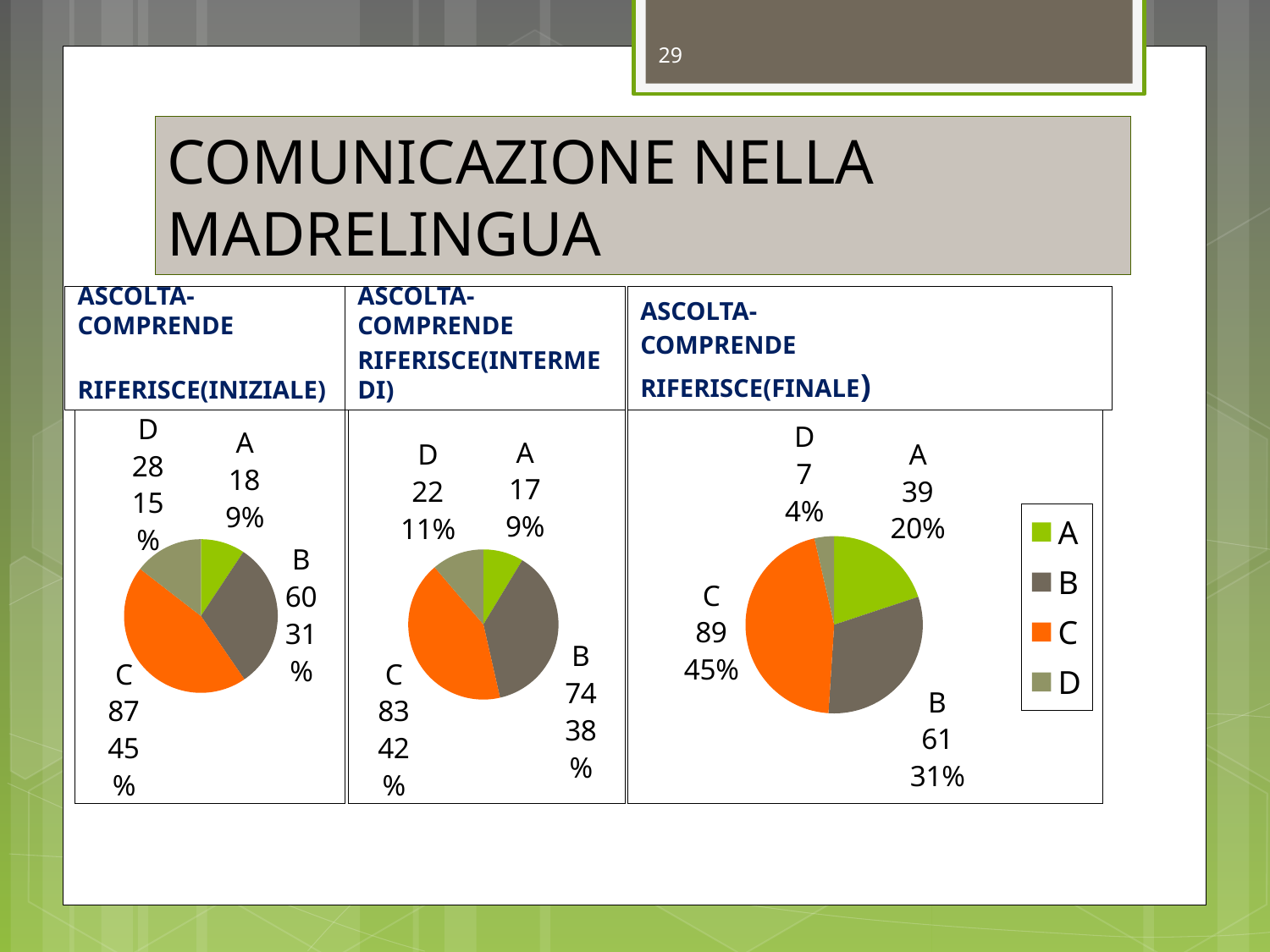
In the ASCOLTA-COMPRENDE RIFERISCE(INIZIALE) chart, what is the value for C? 87 In the ASCOLTA-COMPRENDE RIFERISCE(INIZIALE) chart, what percentage share does B have? 31% In the ASCOLTA-COMPRENDE RIFERISCE(INTERMEDI) chart, which category has the highest value? C What type of chart is used in the ASCOLTA-COMPRENDE RIFERISCE(FINALE) panel? Pie chart In the ASCOLTA-COMPRENDE RIFERISCE(FINALE) chart, what percentage share does D have? 4% How many categories does the legend of the ASCOLTA-COMPRENDE RIFERISCE(FINALE) chart list? 4 In the ASCOLTA-COMPRENDE RIFERISCE(INIZIALE) chart, which category has the lowest value? A In the ASCOLTA-COMPRENDE RIFERISCE(FINALE) chart, what is the value for A? 39 In the ASCOLTA-COMPRENDE RIFERISCE(INTERMEDI) chart, what percentage share does D have? 11% In the ASCOLTA-COMPRENDE RIFERISCE(INTERMEDI) chart, what is the difference between the values for C and B? 9 In the ASCOLTA-COMPRENDE RIFERISCE(INTERMEDI) chart, what is the value for B? 74 In the ASCOLTA-COMPRENDE RIFERISCE(FINALE) chart, which is larger, the value for B or the value for A? B